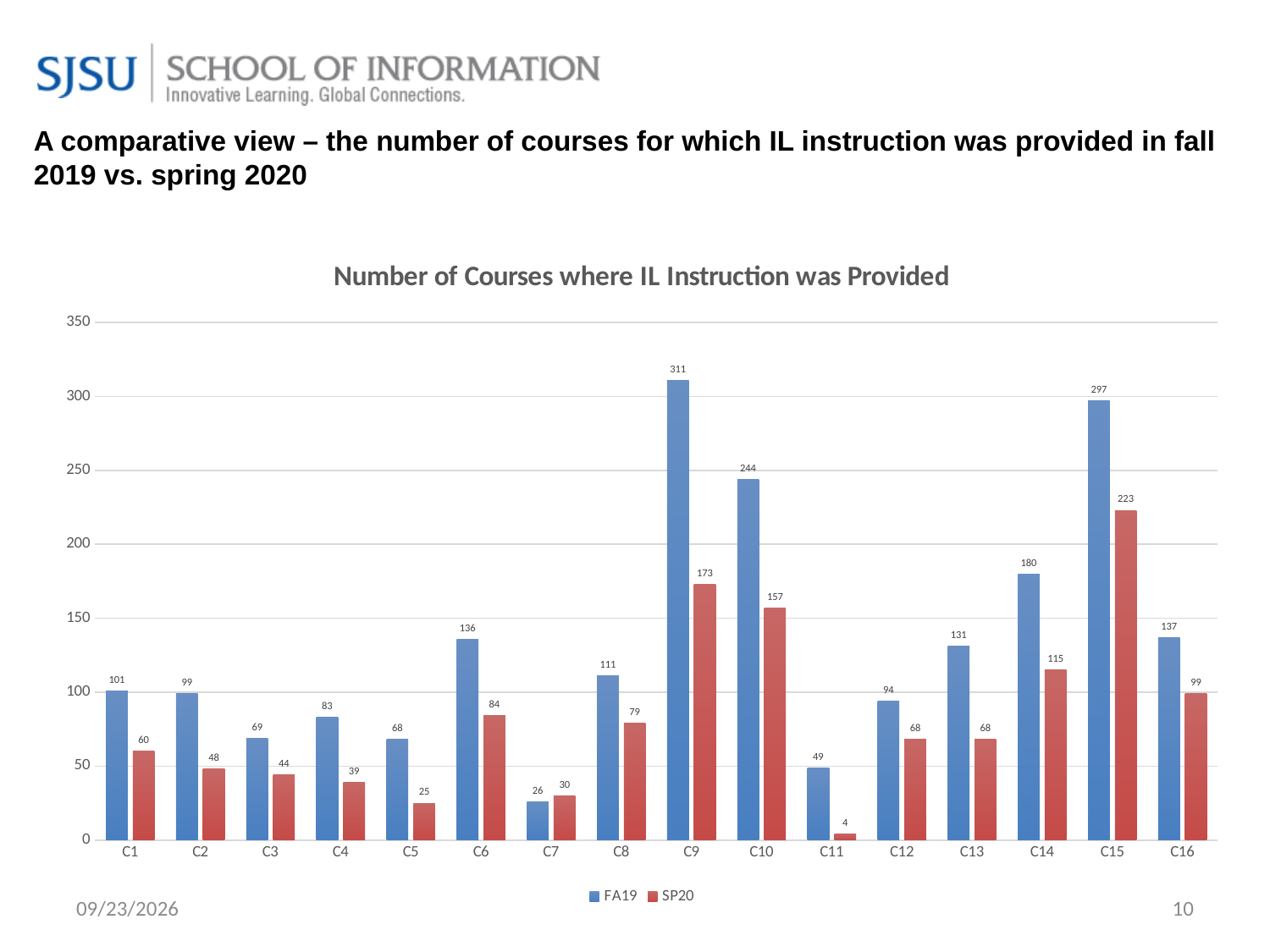
What kind of chart is shown on the slide? Bar chart What is the title of the chart? Number of Courses where IL Instruction was Provided Which category has the highest FA19 value? C9 Which is larger for C7, the FA19 value or the SP20 value? SP20 What colour are the SP20 bars? Red What is the SP20 value for C15? 223 What is the FA19 value for C9? 311 How many series does the legend list? 2 What is the SP20 value for C11? 4 Which category has the lowest SP20 value? C11 What is the difference between the FA19 and SP20 values for C10? 87 How many categories are shown on the x axis? 16